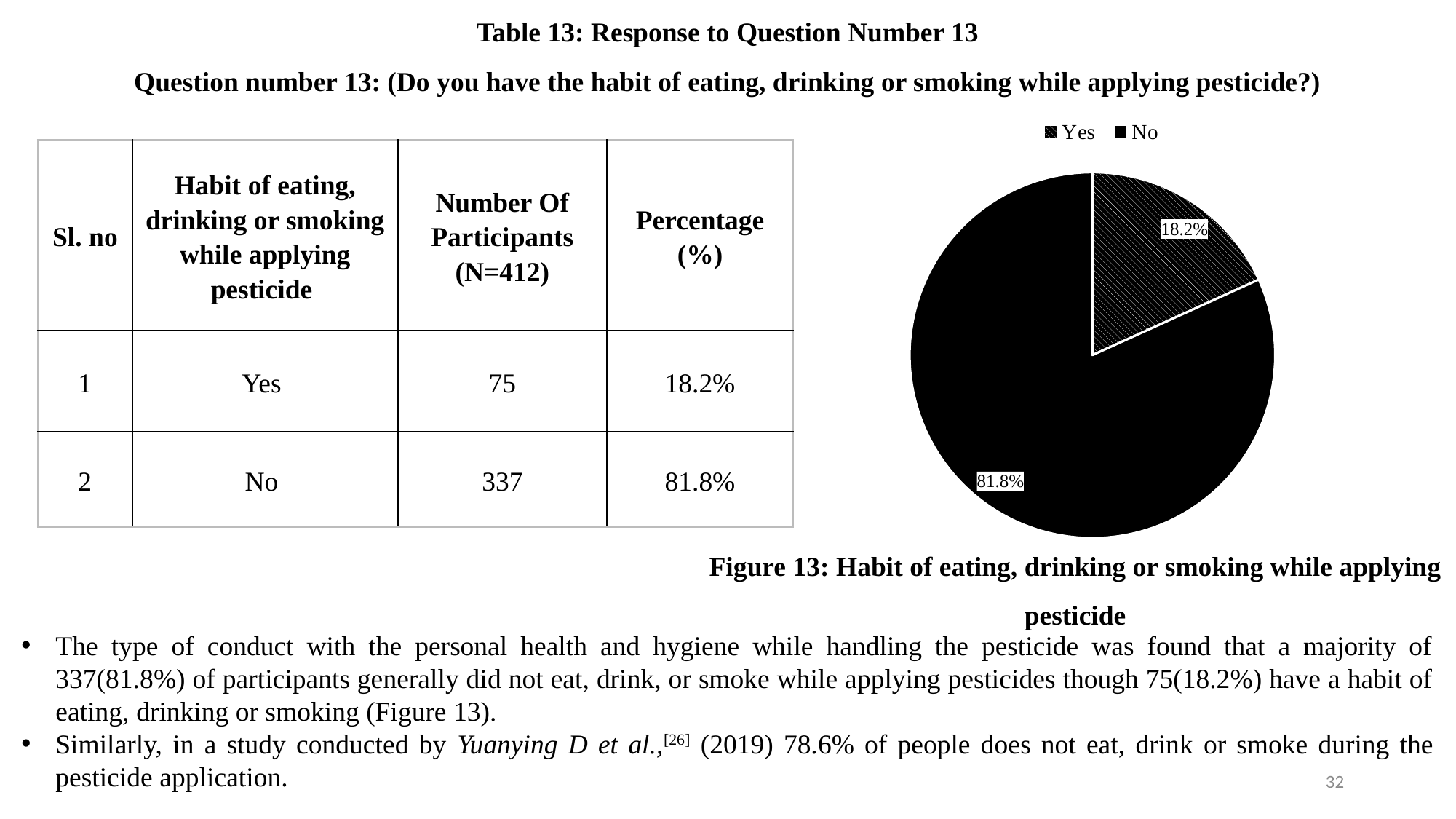
What is the difference in percentage points between the No slice and the Yes slice in the pie chart? 63.6 In the pie chart, which is larger, the Yes slice or the No slice? No What kind of chart is shown in Figure 13? pie chart How many entries does the legend of the pie chart list? 2 Which slice of the pie chart is the smallest? Yes In the pie chart, what percentage is shown for the No slice? 81.8% In the pie chart, what percentage is shown for the Yes slice? 18.2% Which legend entry in the pie chart is shown with a hatched pattern? Yes What share of the pie does the Yes slice represent? 18.2% What is the caption of the pie chart figure? Figure 13: Habit of eating, drinking or smoking while applying pesticide Which slice of the pie chart is the largest? No How many slices does the pie chart have? 2